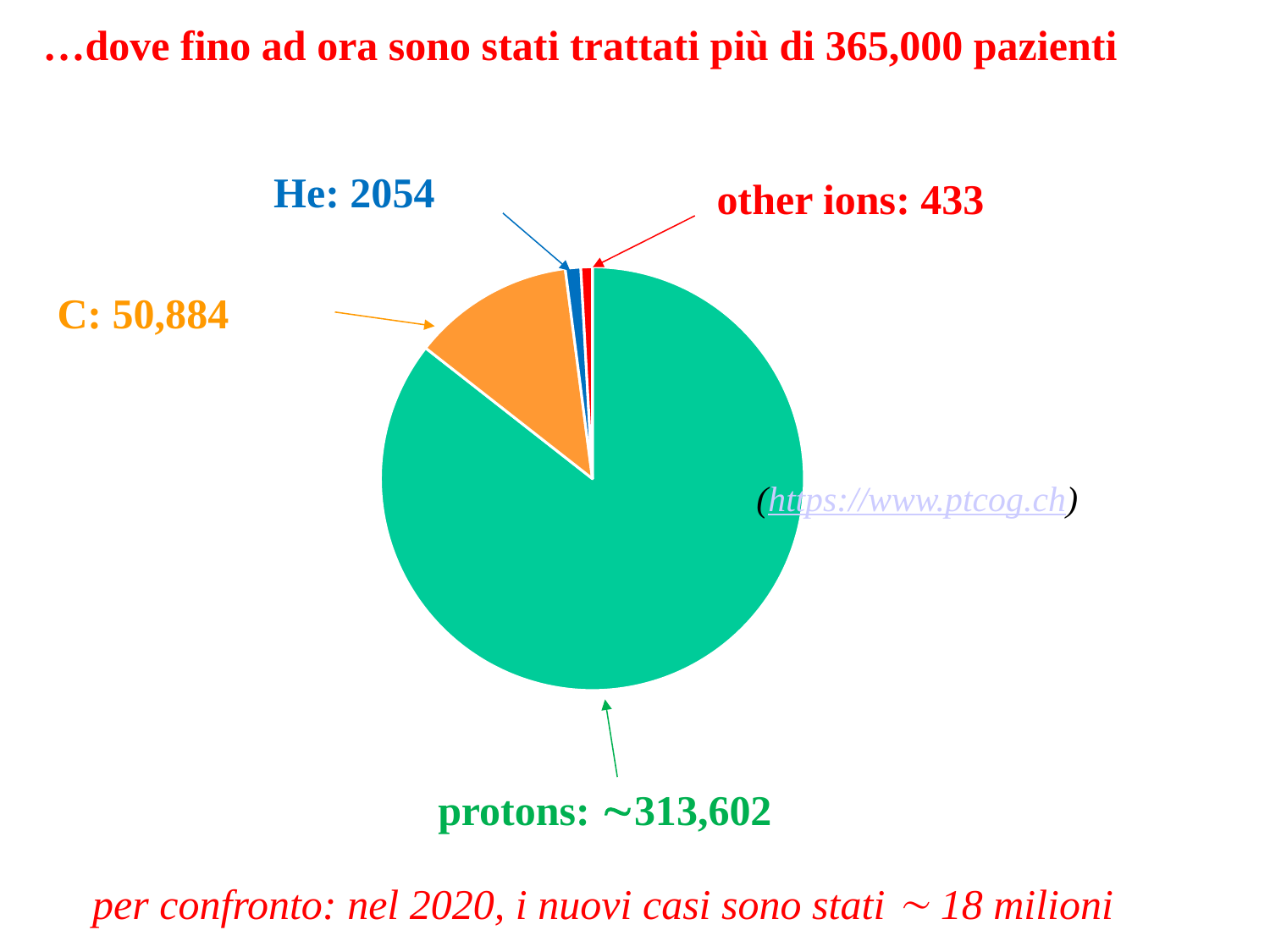
What is the value shown for other ions in the pie chart? 433 Which category has the largest slice of the pie chart? protons What is the difference between the value for He and the value for other ions? 1621 Which is larger, the value for C or the value for He? C How many slices does the pie chart have? 4 What is the difference between the value for C and the value for He? 48,830 What kind of chart is shown on the slide? pie chart What is the value shown for C in the pie chart? 50,884 What colour is the slice for C in the pie chart? orange Which category has the smallest slice of the pie chart? other ions What is the value shown for He in the pie chart? 2054 Which is larger, the value for He or the value for other ions? He